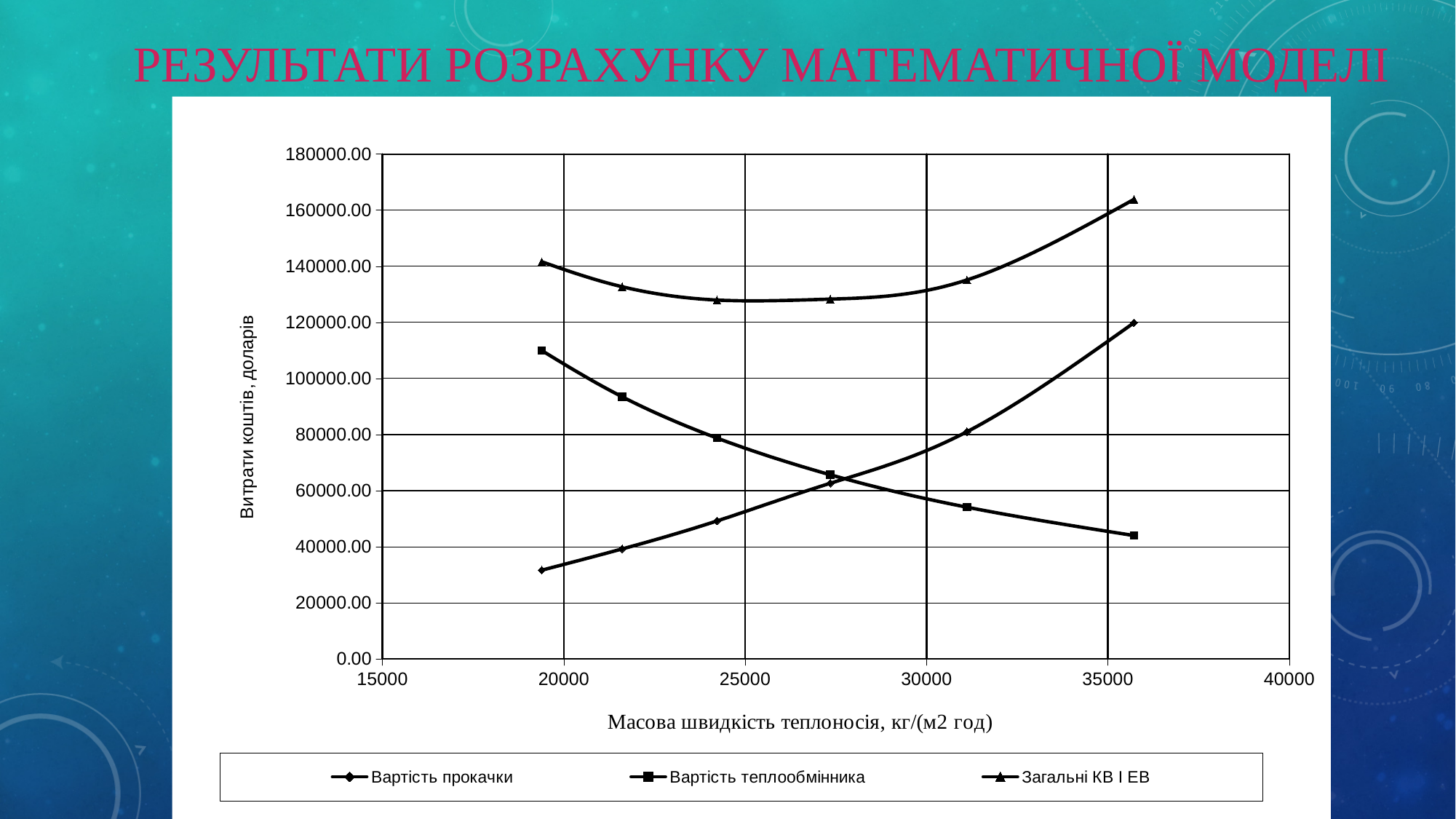
Do the values of Вартість теплообмінника rise or fall as the mass velocity increases along the x axis? fall How many series does the legend list? 3 At the leftmost plotted point, which is larger: Вартість прокачки or Вартість теплообмінника? Вартість теплообмінника Which series has the highest values across the whole chart? Загальні КВ І ЕВ How many data points are plotted for the series Вартість прокачки? 6 What is the title of the x axis? Масова швидкість теплоносія, кг/(м2 год) Do the values of Вартість прокачки rise or fall as the mass velocity increases along the x axis? rise Is the value of Загальні КВ І ЕВ at its rightmost point greater or less than 160000.00? greater What kind of chart is shown on the slide? line chart Is the value of Вартість прокачки at its leftmost point greater or less than 40000.00? less Is the value of Вартість теплообмінника at its leftmost point greater or less than 100000.00? greater At the rightmost plotted point, which is larger: Вартість прокачки or Вартість теплообмінника? Вартість прокачки